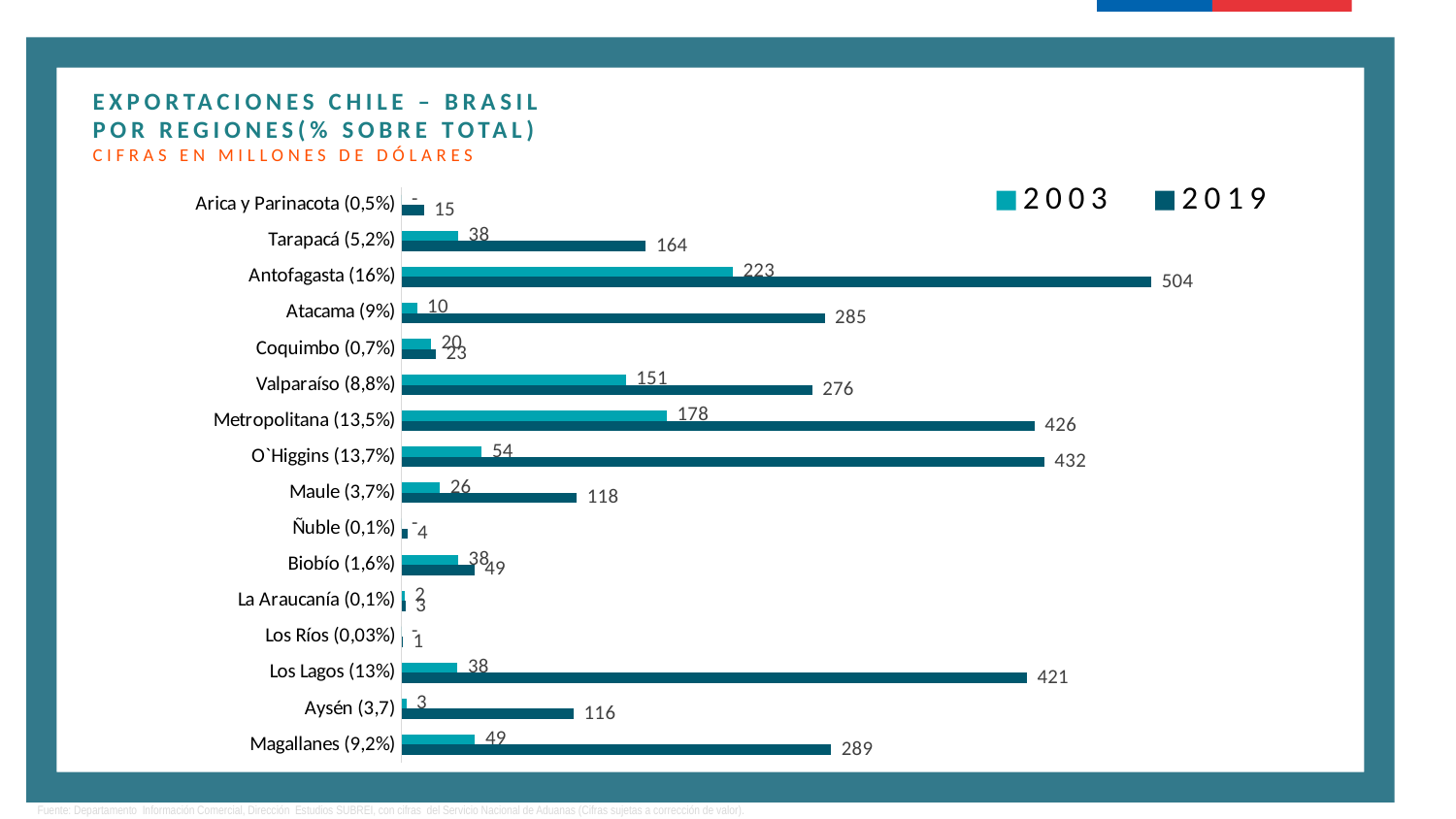
What is the 2003 value for Metropolitana (13,5%)? 178 Which region has the lowest 2019 value? Los Ríos (0,03%) Which region has the highest 2019 value? Antofagasta (16%) How many series does the legend list? 2 How many regions are shown on the chart? 16 What kind of chart is shown on the slide? Bar chart Which years are listed in the chart legend? 2003 and 2019 What is the difference between the 2019 and 2003 values for Magallanes (9,2%)? 240 What is the 2019 value for Los Lagos (13%)? 421 Which is larger: the 2019 value for O`Higgins (13,7%) or the 2019 value for Metropolitana (13,5%)? O`Higgins (13,7%) What is the 2003 value for Valparaíso (8,8%)? 151 What is the 2019 value for Antofagasta (16%)? 504